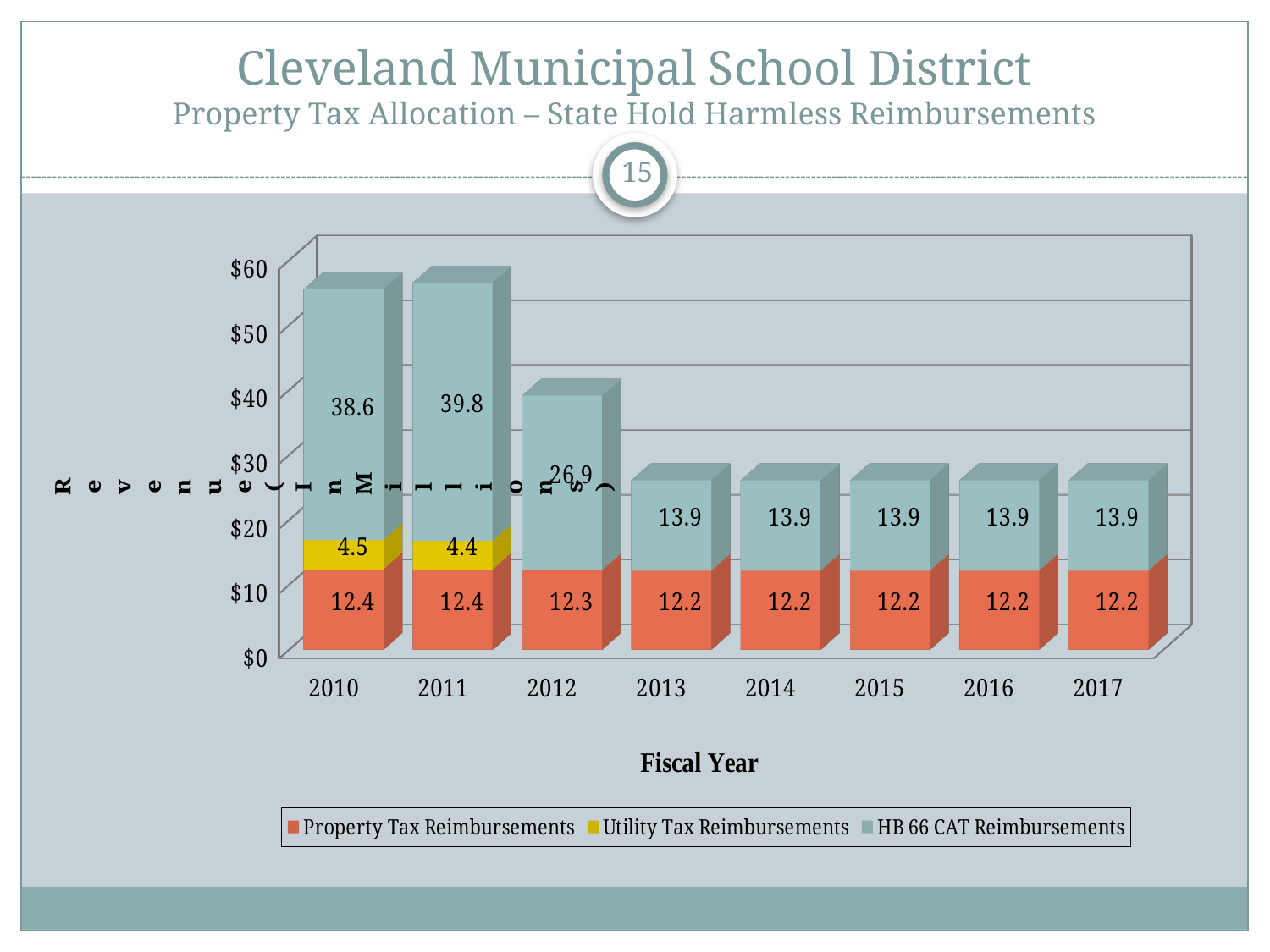
What kind of chart is shown on the slide? Bar chart Which year has the larger Utility Tax Reimbursements value, 2010 or 2011? 2010 How many series does the legend list? 3 What is the value of Property Tax Reimbursements for 2012? 12.3 What is the title of the x axis? Fiscal Year What is the value of HB 66 CAT Reimbursements for 2011? 39.8 What is the difference between HB 66 CAT Reimbursements in 2011 and 2010? 1.2 How many fiscal years are shown on the x axis? 8 What is the value of Utility Tax Reimbursements for 2010? 4.5 What is the total of the stacked bar for 2010? 55.5 In which fiscal year are HB 66 CAT Reimbursements highest? 2011 Do the total bar heights rise or fall from 2011 to 2013? Fall